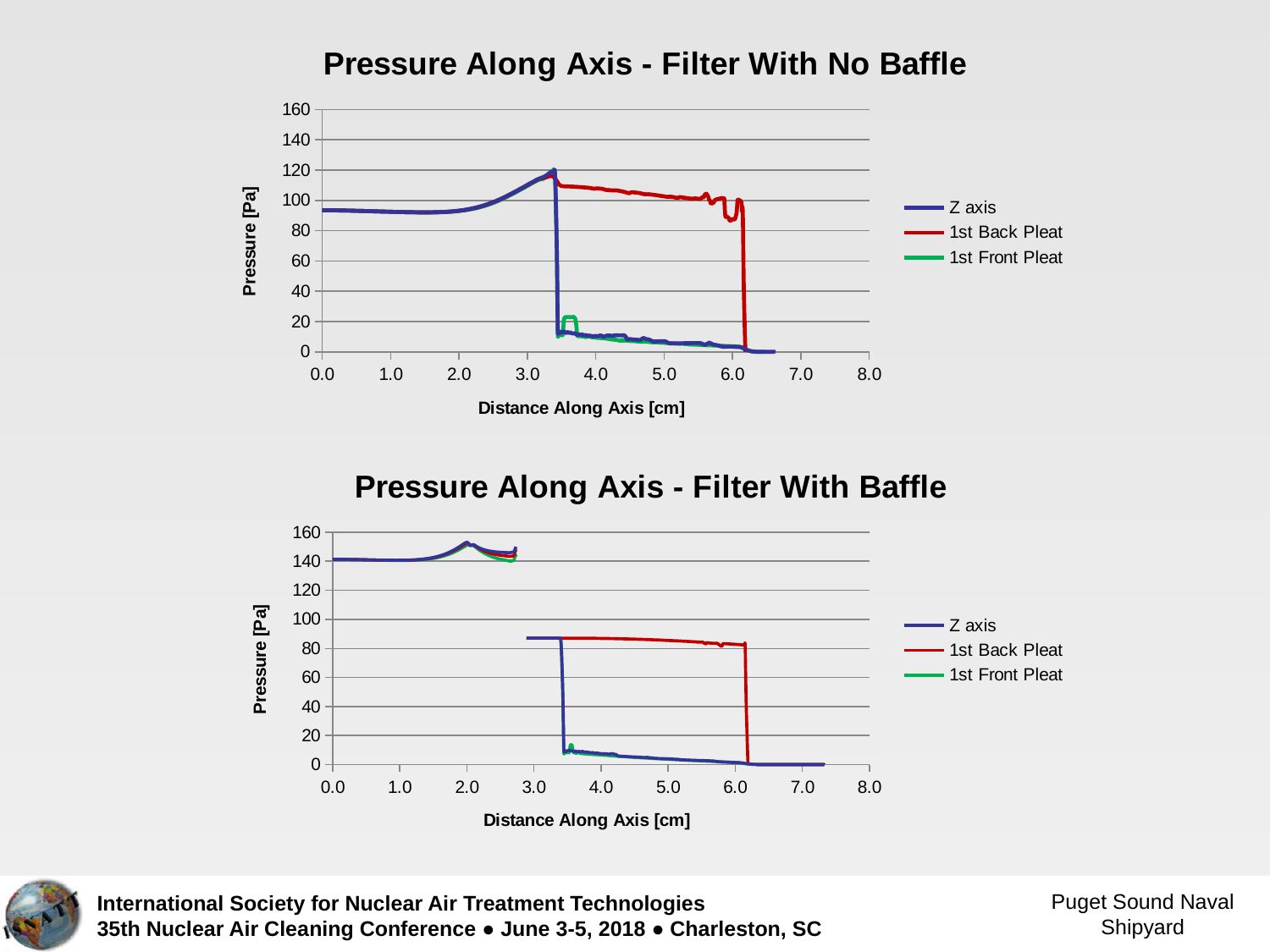
In the bottom chart, 'Filter With Baffle', is the Z axis pressure at a distance of 0.0 cm greater or less than 120? greater What is the label of the vertical axis on the top chart? Pressure [Pa] In the top chart, 'Filter With No Baffle', does the Z axis pressure rise or fall between distances of 0.0 cm and 3.0 cm? rise How many series does the legend of the bottom chart, 'Pressure Along Axis - Filter With Baffle', list? 3 In the bottom chart, 'Filter With Baffle', does the 1st Back Pleat pressure rise or fall between distances of 4.0 cm and 6.0 cm? fall In the top chart, 'Filter With No Baffle', is the Z axis pressure at a distance of 0.0 cm greater or less than 80? greater Comparing the two charts, is the Z axis pressure at a distance of 0.0 cm higher in the 'Filter With No Baffle' chart or the 'Filter With Baffle' chart? Filter With Baffle In the top chart, 'Filter With No Baffle', at a distance of 5.0 cm, which series has the higher pressure: 1st Back Pleat or 1st Front Pleat? 1st Back Pleat In the bottom chart, 'Filter With Baffle', is the Z axis pressure at a distance of 5.0 cm greater or less than 20? less What type of chart is the top chart, 'Pressure Along Axis - Filter With No Baffle'? line chart